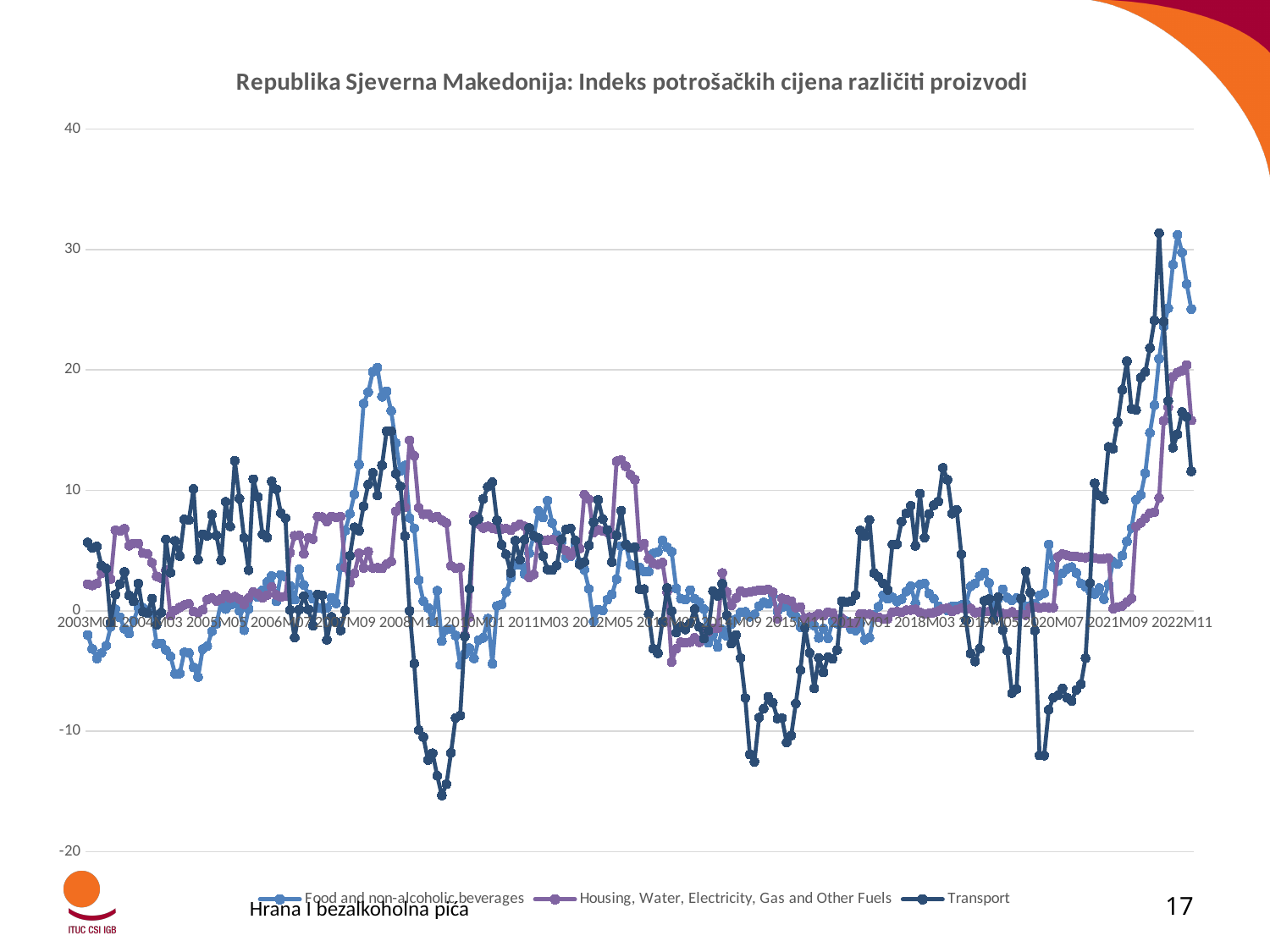
Is the highest value of the Food and non-alcoholic beverages series greater or less than 20? greater Is the highest value of the Housing, Water, Electricity, Gas and Other Fuels series greater or less than 10? greater How many series does the legend list? 3 What is the title of the chart? Republika Sjeverna Makedonija: Indeks potrošačkih cijena različiti proizvodi What is the highest value shown on the vertical axis? 40 What is the last label shown on the horizontal axis? 2022M11 Which series is shown in the dark navy line? Transport Is the lowest value of the Transport series greater or less than -10? less Which series reaches the lowest value anywhere on the chart? Transport Does the Food and non-alcoholic beverages series rise or fall between 2021M09 and mid-2022? rise What kind of chart is shown on the slide? line chart